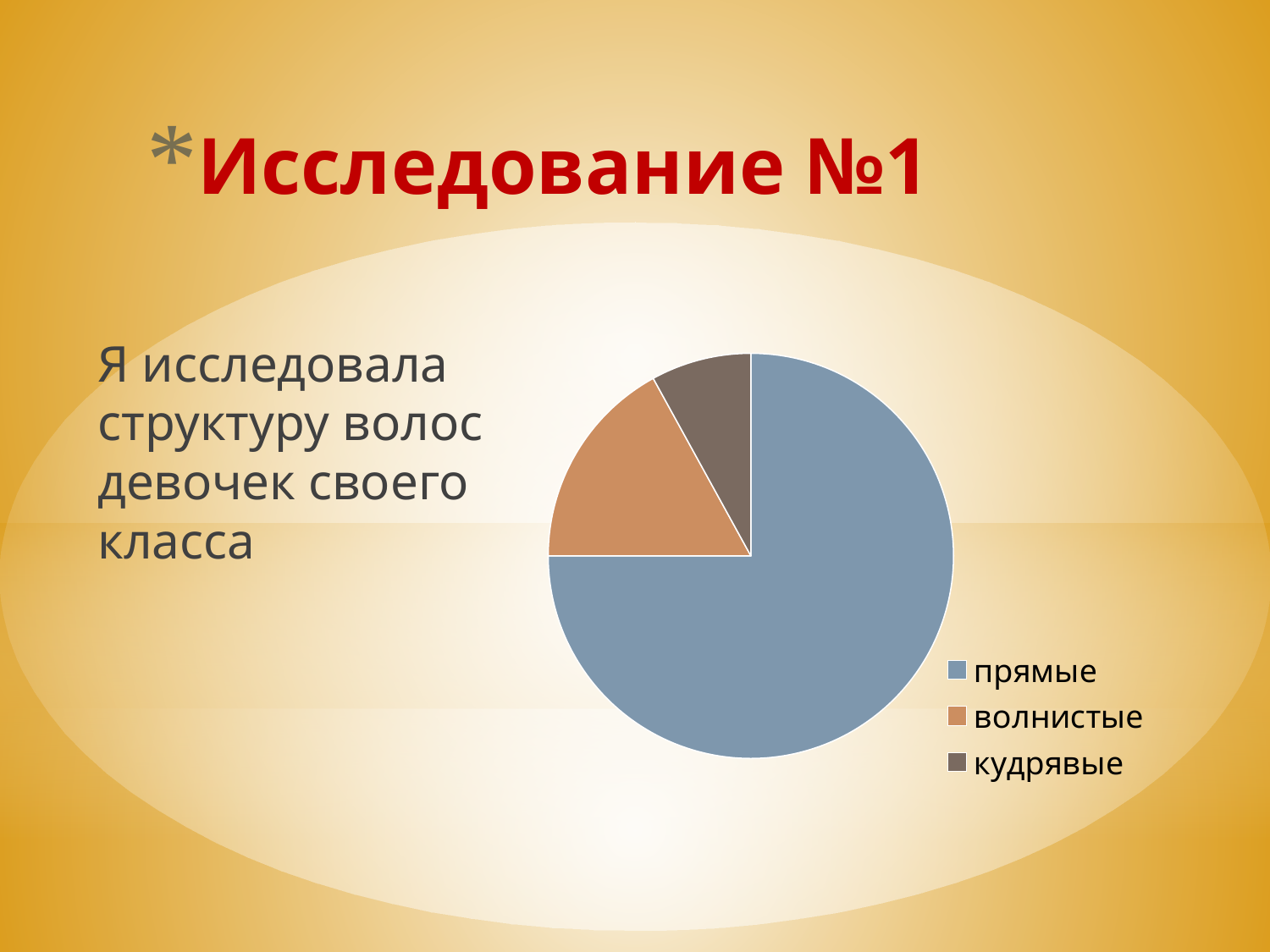
Which category has the largest slice in the pie chart? прямые How many slices does the pie chart have? 3 Which slice is larger in the pie chart, волнистые or кудрявые? волнистые Which slice is larger in the pie chart, прямые or волнистые? прямые How many entries does the legend of the pie chart list? 3 What colour is the slice for прямые in the pie chart? blue Does the прямые slice take up more or less than half of the pie chart? more What kind of chart is shown on the slide? pie chart Which category is shown in orange in the pie chart? волнистые Which category has the smallest slice in the pie chart? кудрявые